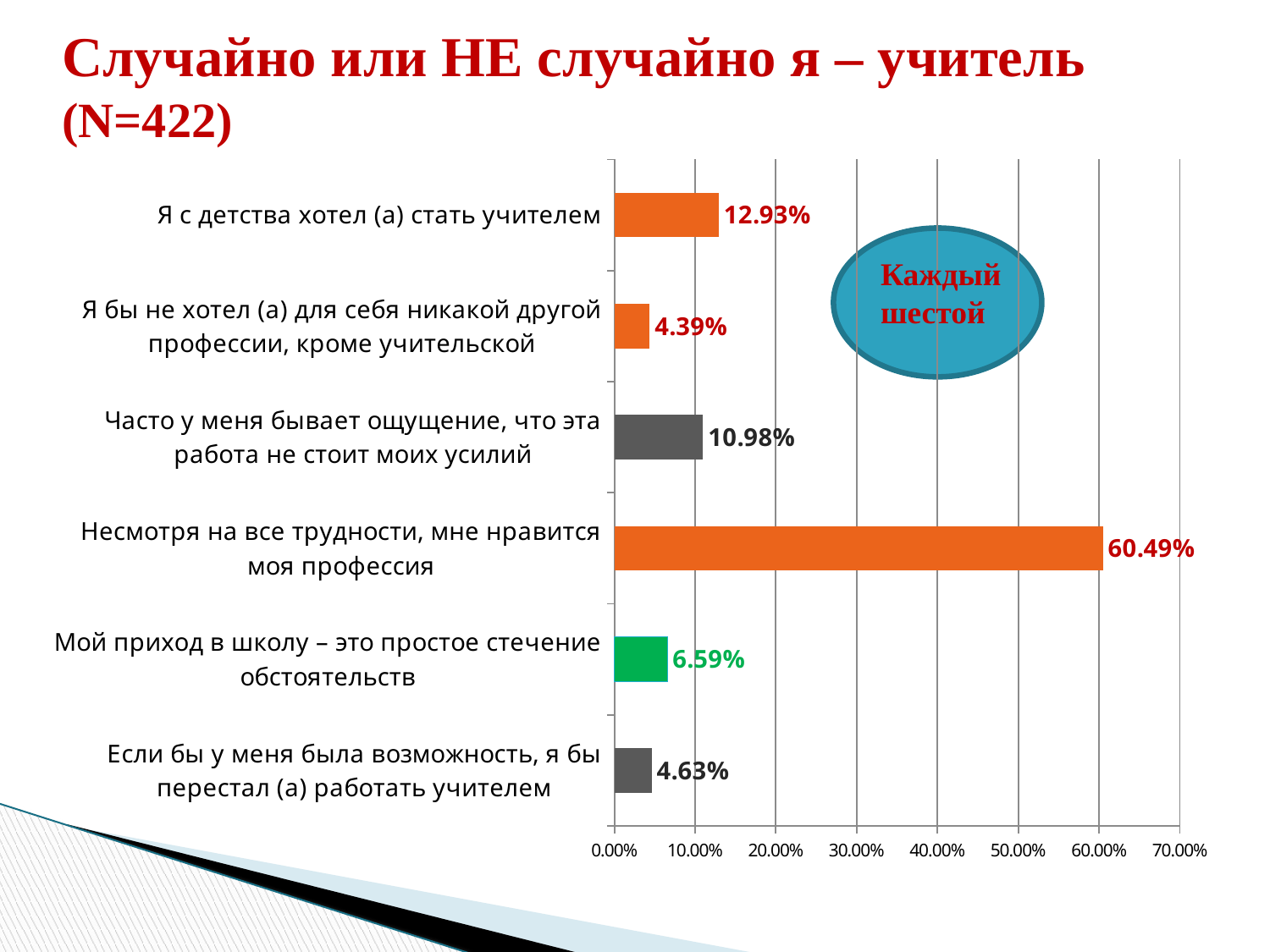
What is the value for "Часто у меня бывает ощущение, что эта работа не стоит моих усилий"? 10.98% Which is larger: the value for "Мой приход в школу – это простое стечение обстоятельств" or for "Если бы у меня была возможность, я бы перестал (а) работать учителем"? Мой приход в школу – это простое стечение обстоятельств What kind of chart is shown on the slide? bar chart What is the value for "Я с детства хотел (а) стать учителем"? 12.93% Is the value for "Несмотря на все трудности, мне нравится моя профессия" greater or less than 50.00%? greater What is the difference between the values for "Несмотря на все трудности, мне нравится моя профессия" and "Я с детства хотел (а) стать учителем"? 47.56% What is the value for "Мой приход в школу – это простое стечение обстоятельств"? 6.59% How many categories are shown in the chart? 6 Which category has the lowest value? Я бы не хотел (а) для себя никакой другой профессии, кроме учительской Which category has the highest value? Несмотря на все трудности, мне нравится моя профессия What is the value for "Несмотря на все трудности, мне нравится моя профессия"? 60.49% What text is written inside the blue oval on the chart? Каждый шестой